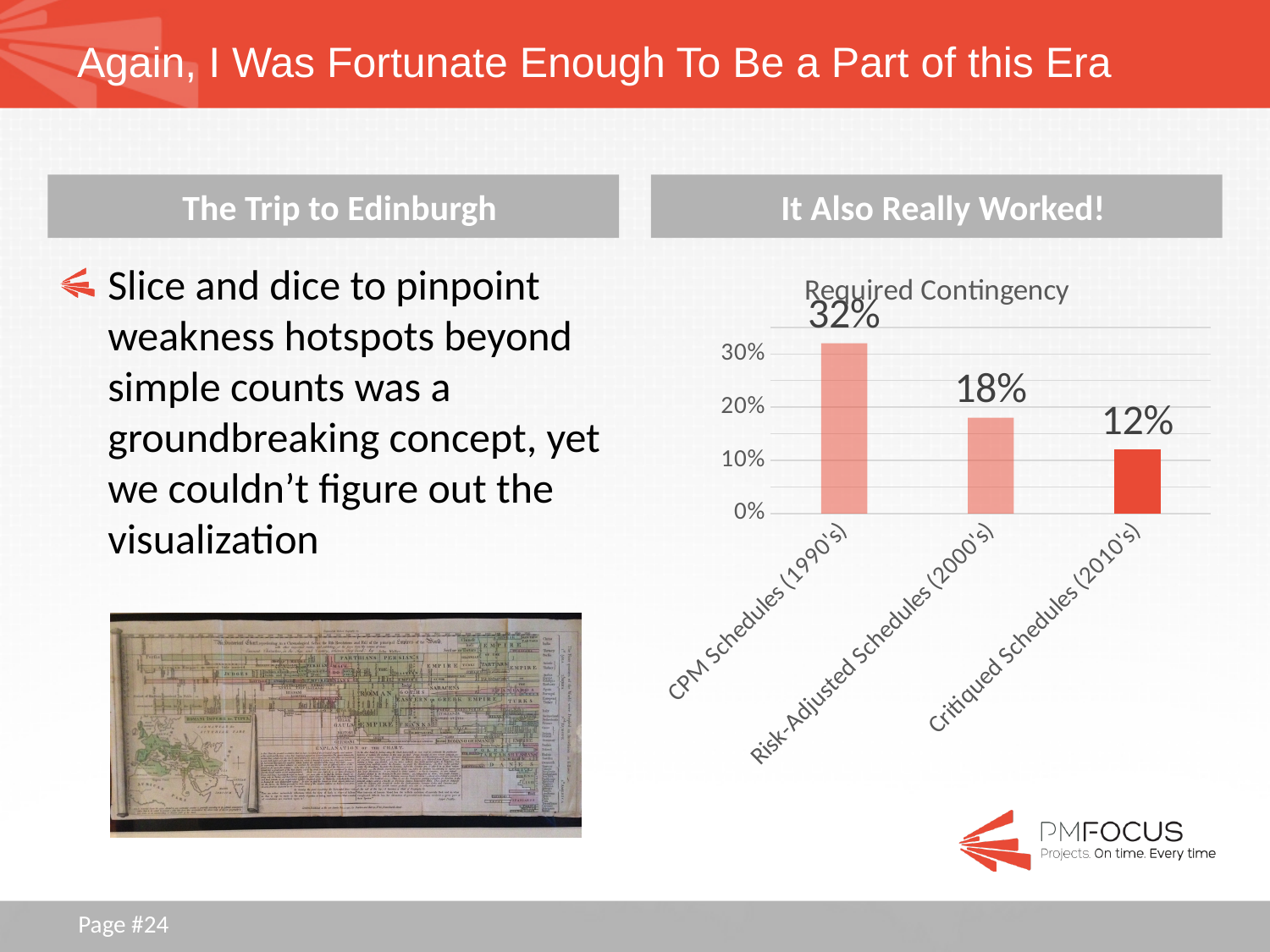
What is the difference in Required Contingency between CPM Schedules (1990's) and Critiqued Schedules (2010's)? 20% What kind of chart is the Required Contingency chart? bar chart What is the Required Contingency value for Critiqued Schedules (2010's)? 12% Is the Required Contingency for Risk-Adjusted Schedules (2000's) greater or less than 20%? less What is the difference in Required Contingency between Risk-Adjusted Schedules (2000's) and Critiqued Schedules (2010's)? 6% Which category has the highest Required Contingency? CPM Schedules (1990's) Which has a larger Required Contingency, CPM Schedules (1990's) or Risk-Adjusted Schedules (2000's)? CPM Schedules (1990's) What is the Required Contingency value for Risk-Adjusted Schedules (2000's)? 18% Which category has the lowest Required Contingency? Critiqued Schedules (2010's) How many categories are shown in the Required Contingency chart? 3 What is the Required Contingency value for CPM Schedules (1990's)? 32% Do the Required Contingency values rise or fall from left to right across the categories? fall